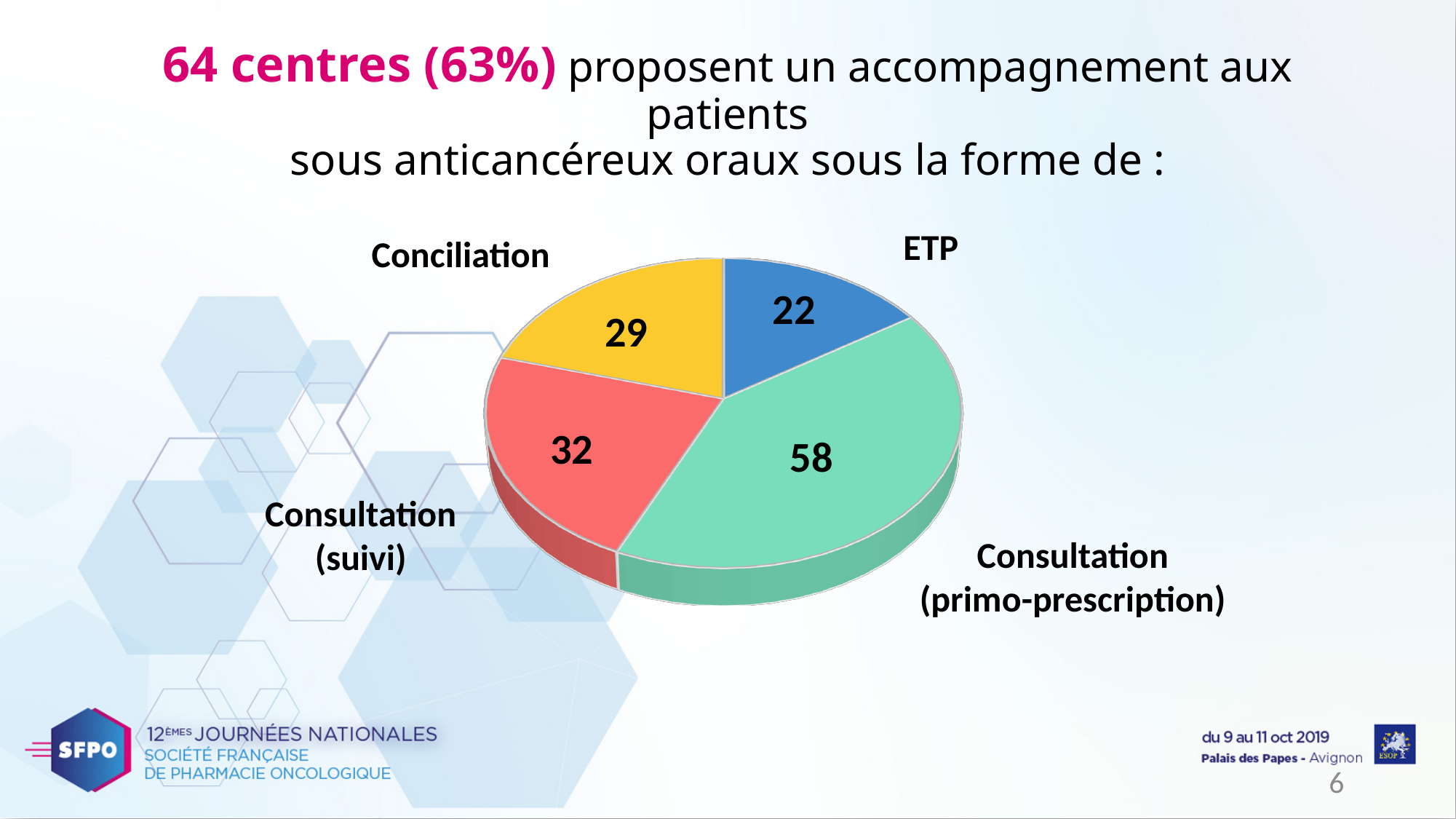
Which category has the smallest slice of the pie chart? ETP Which is larger, the Conciliation slice or the ETP slice? Conciliation Which category has the largest slice of the pie chart? Consultation (primo-prescription) What kind of chart is shown on the slide? Pie chart What colour is the Conciliation slice of the pie chart? Yellow What value is shown for the ETP slice of the pie chart? 22 What is the difference between the Consultation (suivi) value and the Conciliation value? 3 What is the difference between the Consultation (primo-prescription) value and the Consultation (suivi) value? 26 How many categories are shown in the pie chart? 4 What value is shown for the Conciliation slice? 29 What value is shown for the Consultation (primo-prescription) slice? 58 What value is shown for the Consultation (suivi) slice? 32